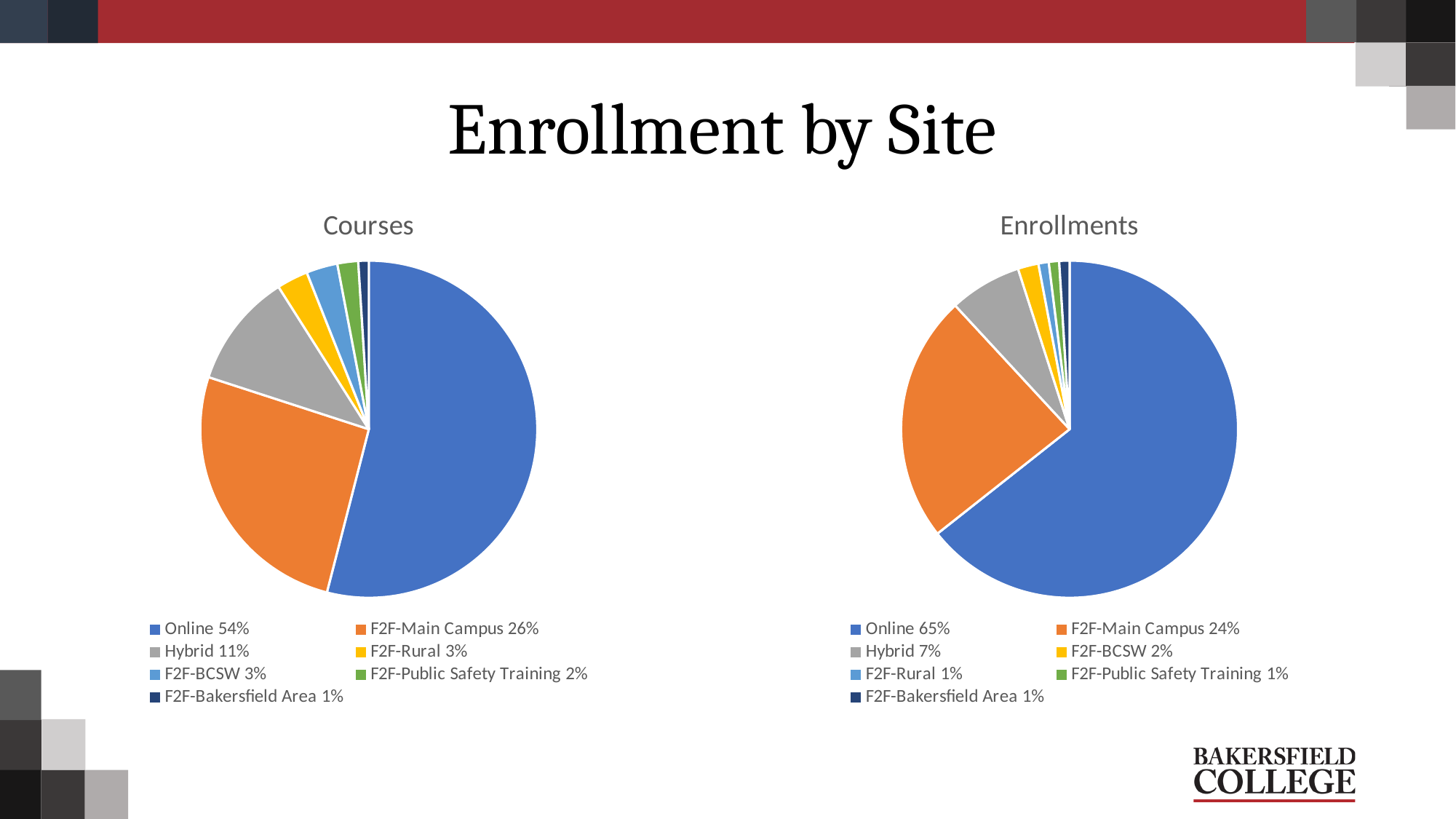
In the Courses pie chart, which category has the largest slice? Online In the Enrollments pie chart, what share does Online have? 65% In the Courses pie chart, what share does Online have? 54% In the Enrollments pie chart, which category has the smallest slice among those with a unique value? F2F-BCSW What is the title of the slide? Enrollment by Site In the Enrollments pie chart, what share does Hybrid have? 7% How many categories does the Courses pie chart show? 7 In the Enrollments pie chart, what is the difference between the Online share and the F2F-Main Campus share? 41 percentage points In the Courses pie chart, what is the difference between the Online share and the F2F-Main Campus share? 28 percentage points Which is larger: the Hybrid share in the Courses chart or the Hybrid share in the Enrollments chart? Courses (11%) What type of chart is used for Enrollments? Pie chart